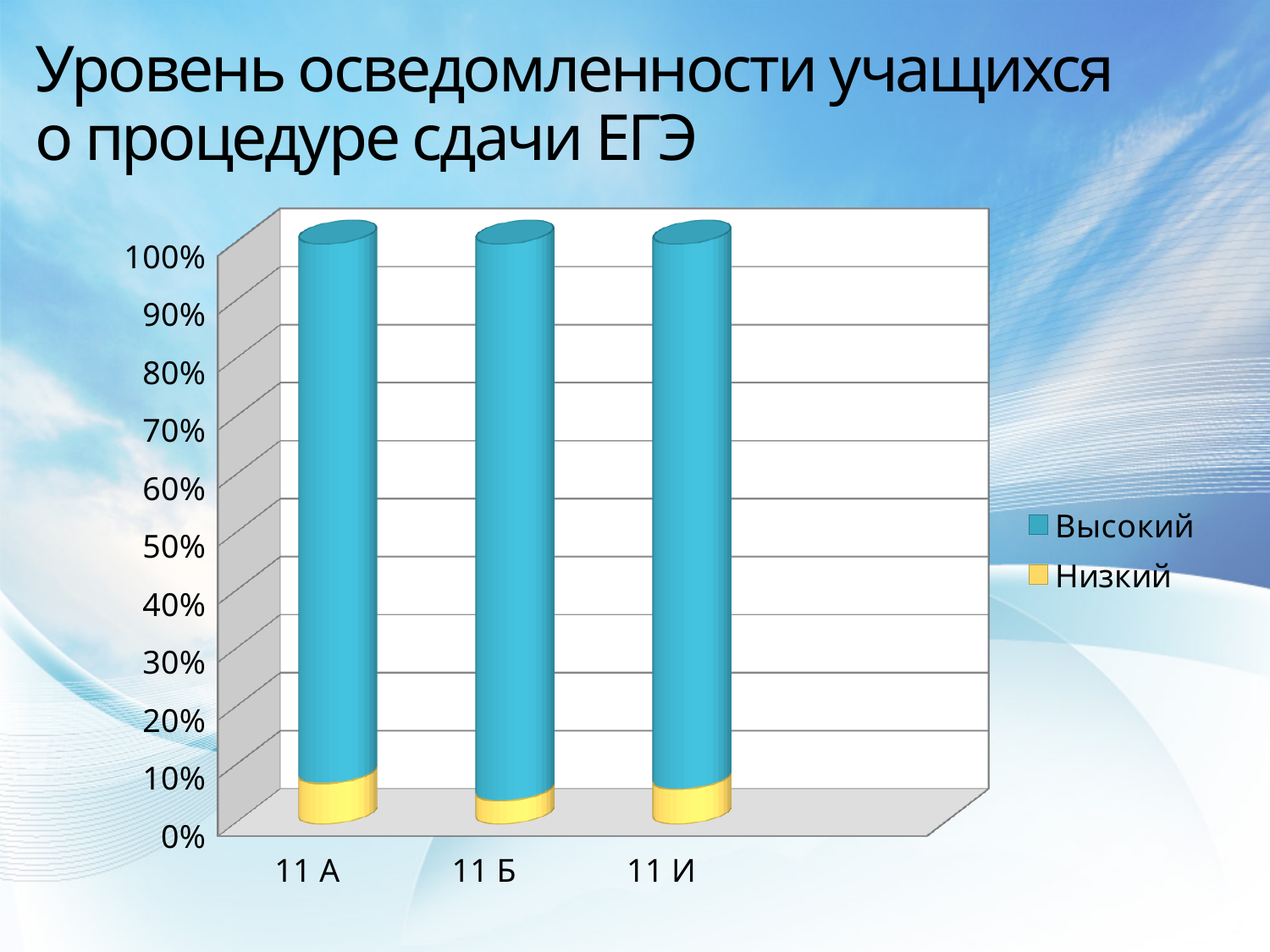
What is the title of the slide containing the chart? Уровень осведомленности учащихся о процедуре сдачи ЕГЭ How many series does the chart legend list? 2 Which is larger, the Низкий value for 11 А or for 11 Б? 11 А Is the value of Низкий for 11 А greater or less than 20%? less What are the category labels on the x axis of the chart? 11 А, 11 Б, 11 И Is the value of Высокий for 11 Б greater or less than 80%? greater Is the value of Низкий for 11 Б greater or less than 10%? less Which series is shown in yellow in the chart? Низкий What kind of chart is shown on the slide? bar chart How many classes (categories) are shown on the x axis of the chart? 3